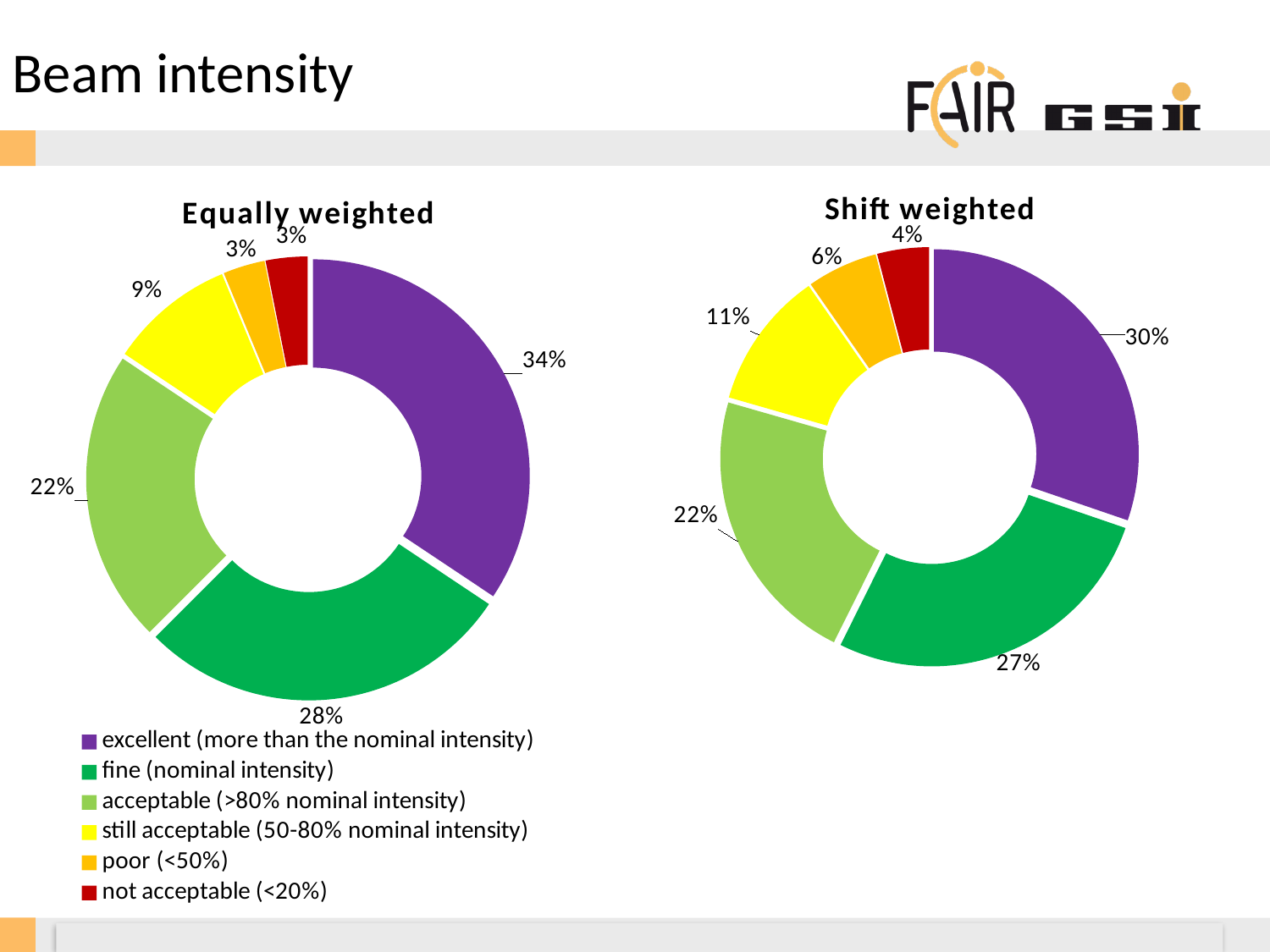
What is the difference between the excellent share in the Equally weighted chart (34%) and in the Shift weighted chart (30%)? 4% In the Equally weighted chart, what share is labelled for the poor (<50%) slice? 3% In the Shift weighted chart, which category has the smallest share? not acceptable (<20%) What kind of chart is the Equally weighted chart? doughnut chart In the Equally weighted chart, what is the combined share of the fine (nominal intensity) and acceptable (>80% nominal intensity) slices? 50% How many categories does the legend list? 6 In the Equally weighted chart, which category has the largest share? excellent (more than the nominal intensity) In the Equally weighted chart, what share is labelled for the excellent (more than the nominal intensity) slice? 34% In the Shift weighted chart, what share is labelled for the still acceptable (50-80% nominal intensity) slice? 11% In the Shift weighted chart, which is larger: the share for poor (<50%) or the share for not acceptable (<20%)? poor (<50%) In the Shift weighted chart, what share is labelled for the fine (nominal intensity) slice? 27% Which colour represents the still acceptable (50-80% nominal intensity) category in the legend? yellow